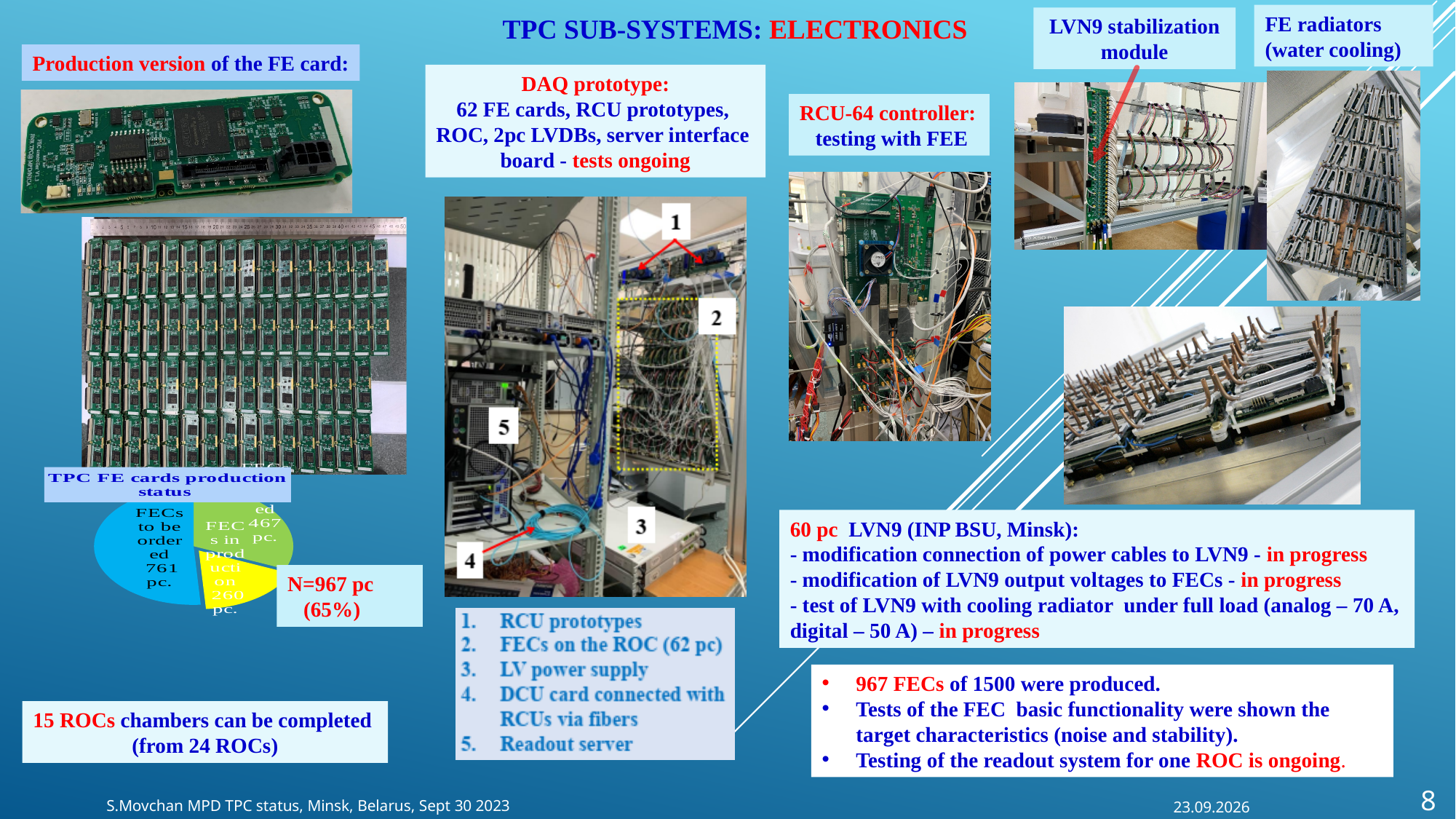
Which slice of the "TPC FE cards production status" pie chart is the smallest? FECs in production How many slices does the "TPC FE cards production status" pie chart have? 3 In the "TPC FE cards production status" pie chart, what is the value for FECs to be ordered? 761 pc. In the "TPC FE cards production status" pie chart, what colour is the FECs to be ordered slice? blue In the "TPC FE cards production status" pie chart, which is larger: FECs to be ordered or FECs in production? FECs to be ordered In the "TPC FE cards production status" pie chart, how much larger is the FECs to be ordered slice (761 pc.) than the green slice (467 pc.)? 294 pc. In the "TPC FE cards production status" pie chart, what is the difference between FECs to be ordered and FECs in production? 501 pc. What kind of chart is the "TPC FE cards production status" chart? pie chart In the "TPC FE cards production status" pie chart, what value is shown on the green slice? 467 pc. In the "TPC FE cards production status" pie chart, what is the value for FECs in production? 260 pc. What is the title of the pie chart on the slide? TPC FE cards production status Which slice of the "TPC FE cards production status" pie chart is the largest? FECs to be ordered